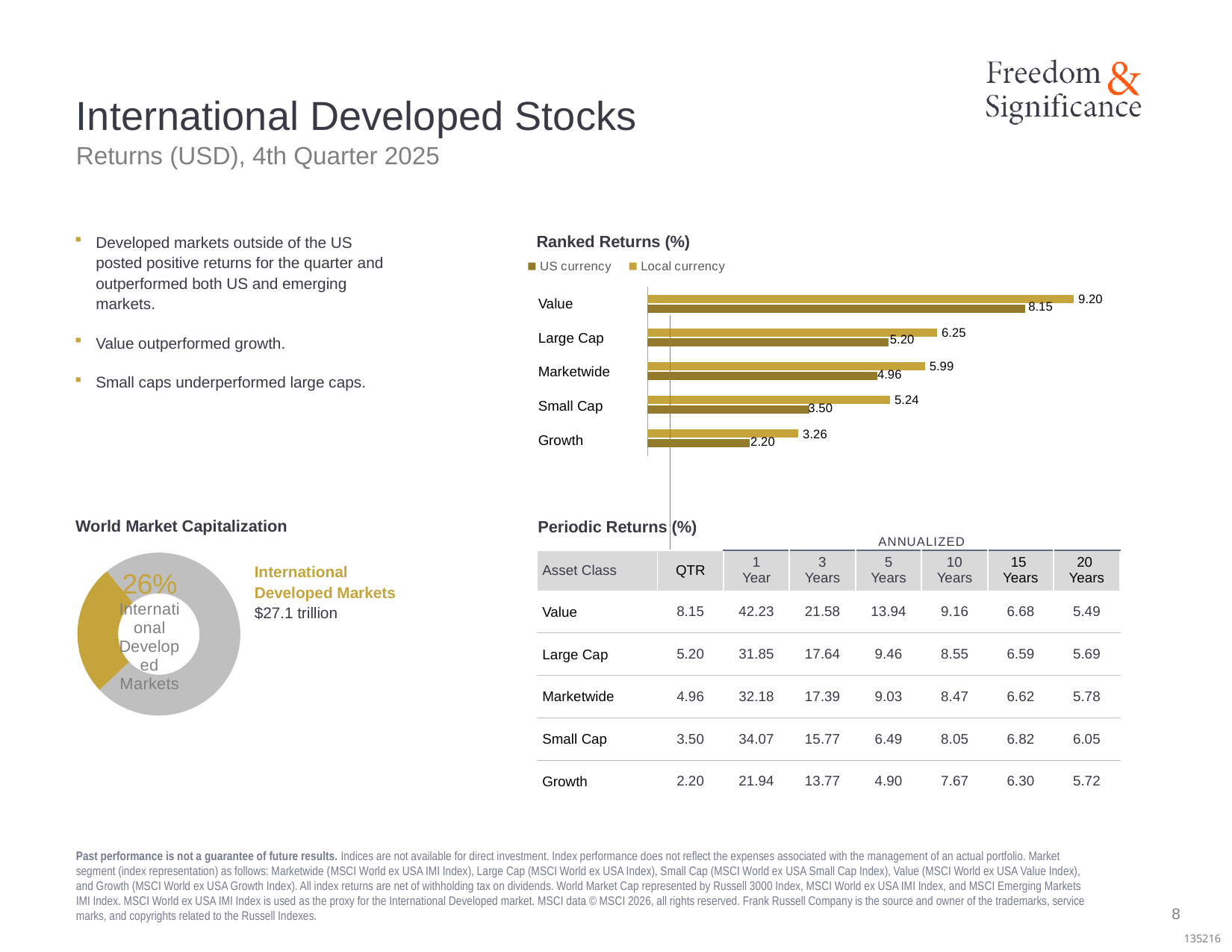
What are the two series named in the legend of the Ranked Returns (%) chart? US currency and Local currency In the Ranked Returns (%) chart, what is the US currency return for Value? 8.15 In the Ranked Returns (%) chart, what is the difference between the Local currency and US currency returns for Large Cap? 1.05 How many categories are shown in the Ranked Returns (%) chart? 5 What kind of chart is the Ranked Returns (%) chart? Bar chart How many series does the legend of the Ranked Returns (%) chart list? 2 In the Ranked Returns (%) chart, which is larger: the US currency return for Marketwide or the US currency return for Small Cap? Marketwide In the Ranked Returns (%) chart, which category has the highest Local currency return? Value In the Ranked Returns (%) chart, which category has the lowest US currency return? Growth In the World Market Capitalization chart, what share is labelled for International Developed Markets? 26% In the Ranked Returns (%) chart, what is the Local currency return for Growth? 3.26 In the Ranked Returns (%) chart, what is the Local currency return for Small Cap? 5.24